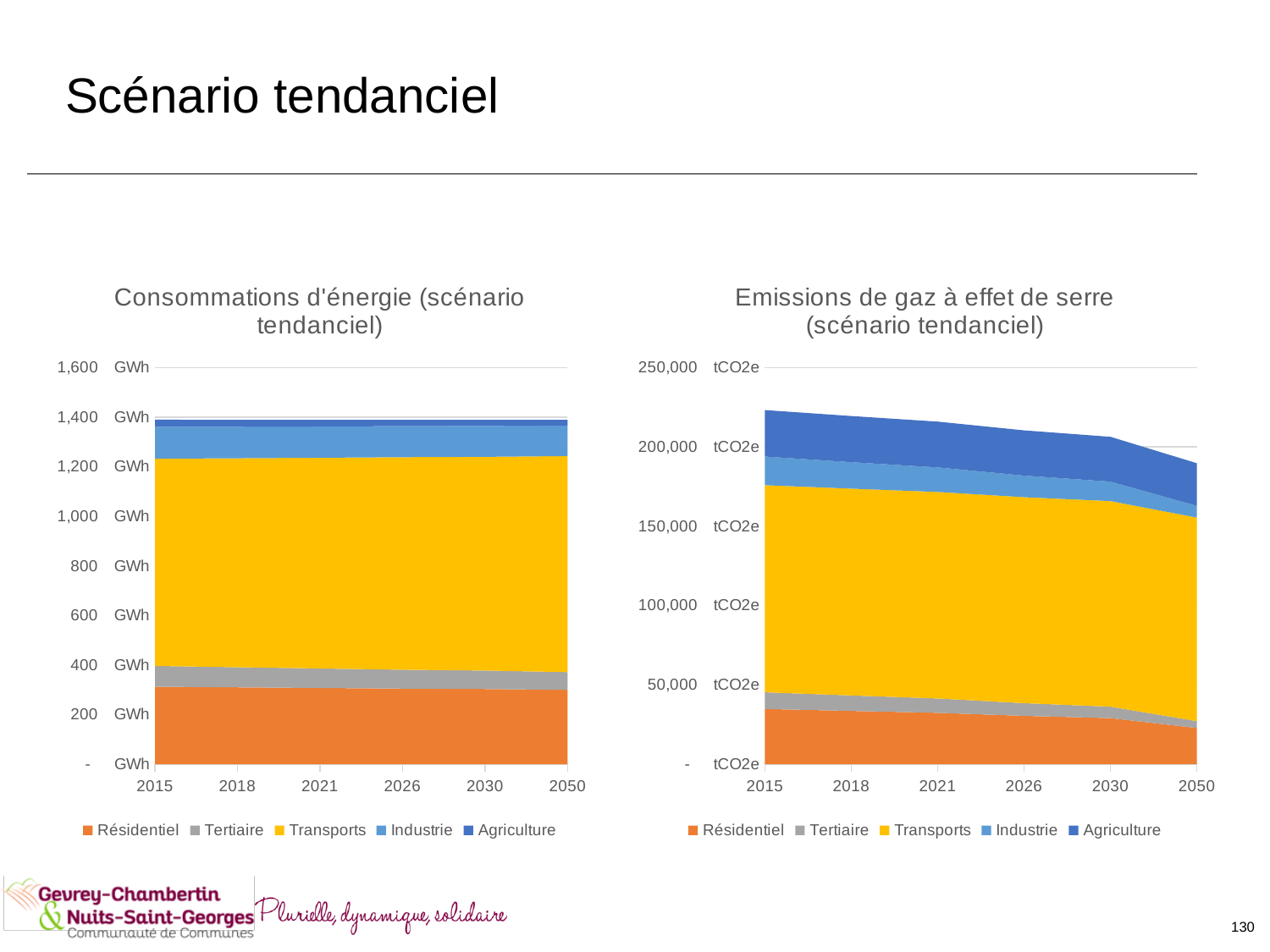
Which colour represents Transports in the legend of the left chart, 'Consommations d'énergie (scénario tendanciel)'? Yellow How many series does the legend of the left chart, 'Consommations d'énergie (scénario tendanciel)', list? 5 In the right chart, 'Emissions de gaz à effet de serre (scénario tendanciel)', is the total value for 2050 greater or less than 200,000 tCO2e? less In the right chart, 'Emissions de gaz à effet de serre (scénario tendanciel)', do total emissions rise or fall from 2015 to 2050? Fall In the left chart, 'Consommations d'énergie (scénario tendanciel)', which sector accounts for the largest share of energy consumption? Transports What unit is used on the y axis of the right chart, 'Emissions de gaz à effet de serre (scénario tendanciel)'? tCO2e How many years are shown on the x axis of the right chart, 'Emissions de gaz à effet de serre (scénario tendanciel)'? 6 What kind of chart is the left chart, 'Consommations d'énergie (scénario tendanciel)'? Stacked area chart In the right chart, 'Emissions de gaz à effet de serre (scénario tendanciel)', which sector accounts for the largest share of emissions? Transports What kind of chart is the right chart, 'Emissions de gaz à effet de serre (scénario tendanciel)'? Stacked area chart In the right chart, 'Emissions de gaz à effet de serre (scénario tendanciel)', is the total value for 2015 greater or less than 200,000 tCO2e? greater In the left chart, 'Consommations d'énergie (scénario tendanciel)', is the total value for 2015 greater or less than 1,200 GWh? greater